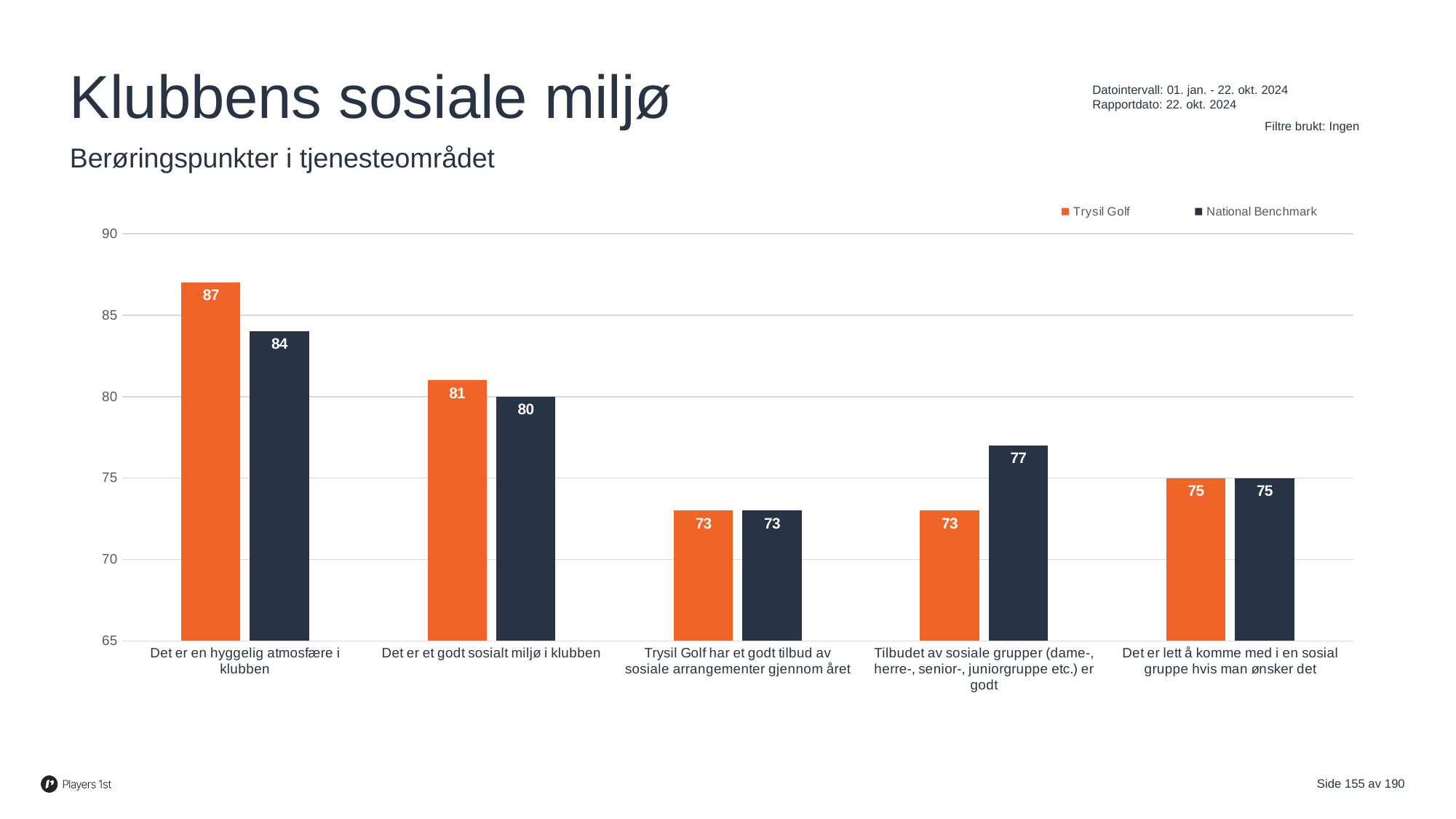
What is the National Benchmark value for "Tilbudet av sosiale grupper (dame-, herre-, senior-, juniorgruppe etc.) er godt"? 77 Which category has the highest Trysil Golf value? Det er en hyggelig atmosfære i klubben How many series does the legend list? 2 For "Det er et godt sosialt miljø i klubben", which series has the larger value, Trysil Golf or National Benchmark? Trysil Golf How many categories are shown on the x axis of the chart? 5 Which colour represents Trysil Golf in the chart? Orange Which category has the lowest National Benchmark value? Trysil Golf har et godt tilbud av sosiale arrangementer gjennom året What is the difference between the Trysil Golf and National Benchmark values for "Det er en hyggelig atmosfære i klubben"? 3 What kind of chart is shown on the slide? Bar chart What is the difference between the National Benchmark and Trysil Golf values for "Tilbudet av sosiale grupper (dame-, herre-, senior-, juniorgruppe etc.) er godt"? 4 What is the Trysil Golf value for "Det er en hyggelig atmosfære i klubben"? 87 What is the National Benchmark value for "Det er et godt sosialt miljø i klubben"? 80